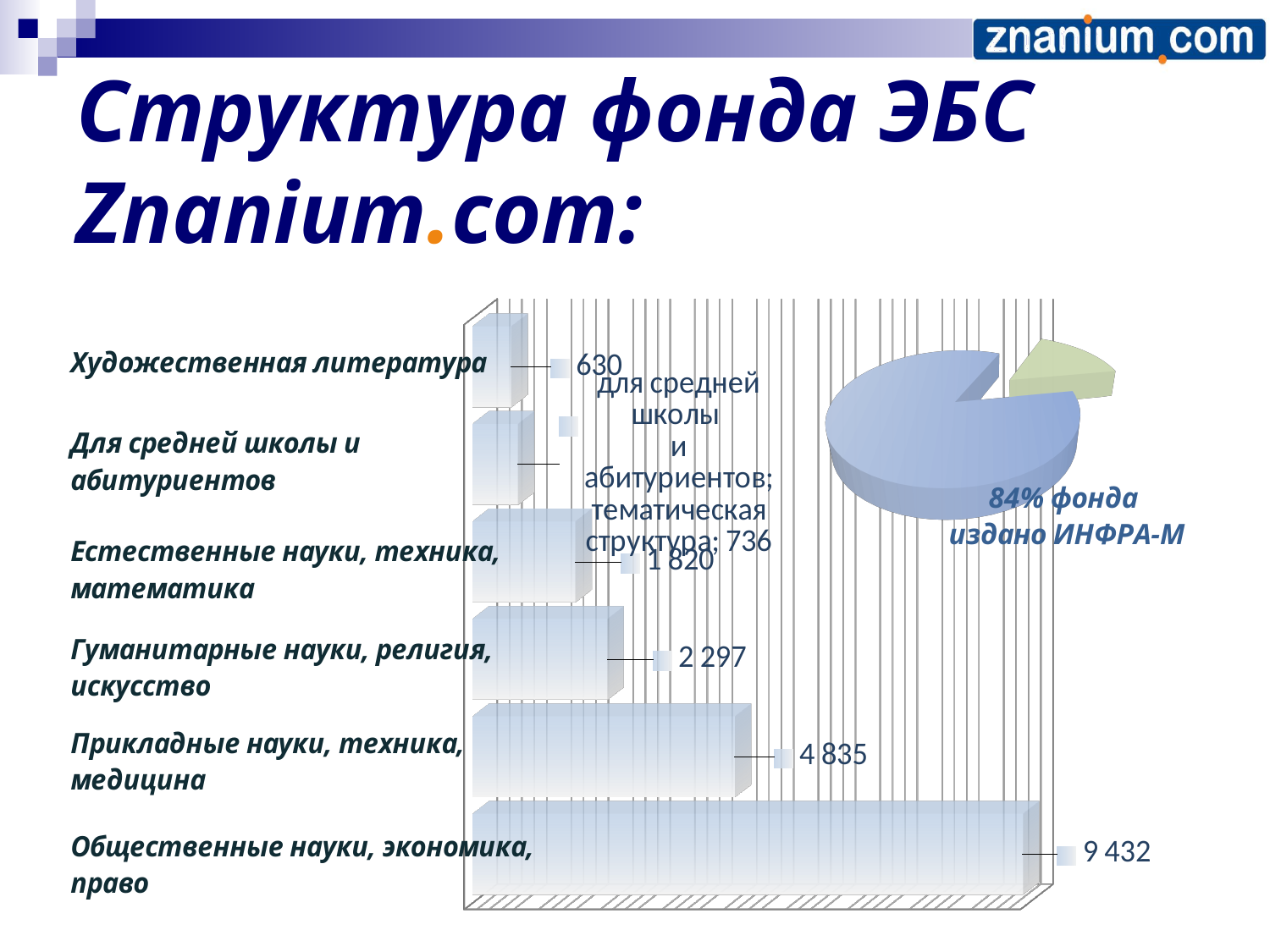
How many categories does the bar chart show? 6 On the bar chart, what is the value for Гуманитарные науки, религия, искусство? 2 297 What kind of chart is the chart on the left side of the slide? bar chart On the bar chart, what is the value for Прикладные науки, техника, медицина? 4 835 On the pie chart in the top right, what share of the fund is published by ИНФРА-М? 84% On the bar chart, what is the value for Для средней школы и абитуриентов? 736 On the bar chart, which category has the highest value? Общественные науки, экономика, право On the bar chart, what is the value for Художественная литература? 630 On the bar chart, what is the value for Общественные науки, экономика, право? 9 432 On the bar chart, which category has the lowest value? Художественная литература On the bar chart, what is the difference between Общественные науки, экономика, право and Прикладные науки, техника, медицина? 4 597 On the bar chart, which is larger: Естественные науки, техника, математика or Гуманитарные науки, религия, искусство? Гуманитарные науки, религия, искусство